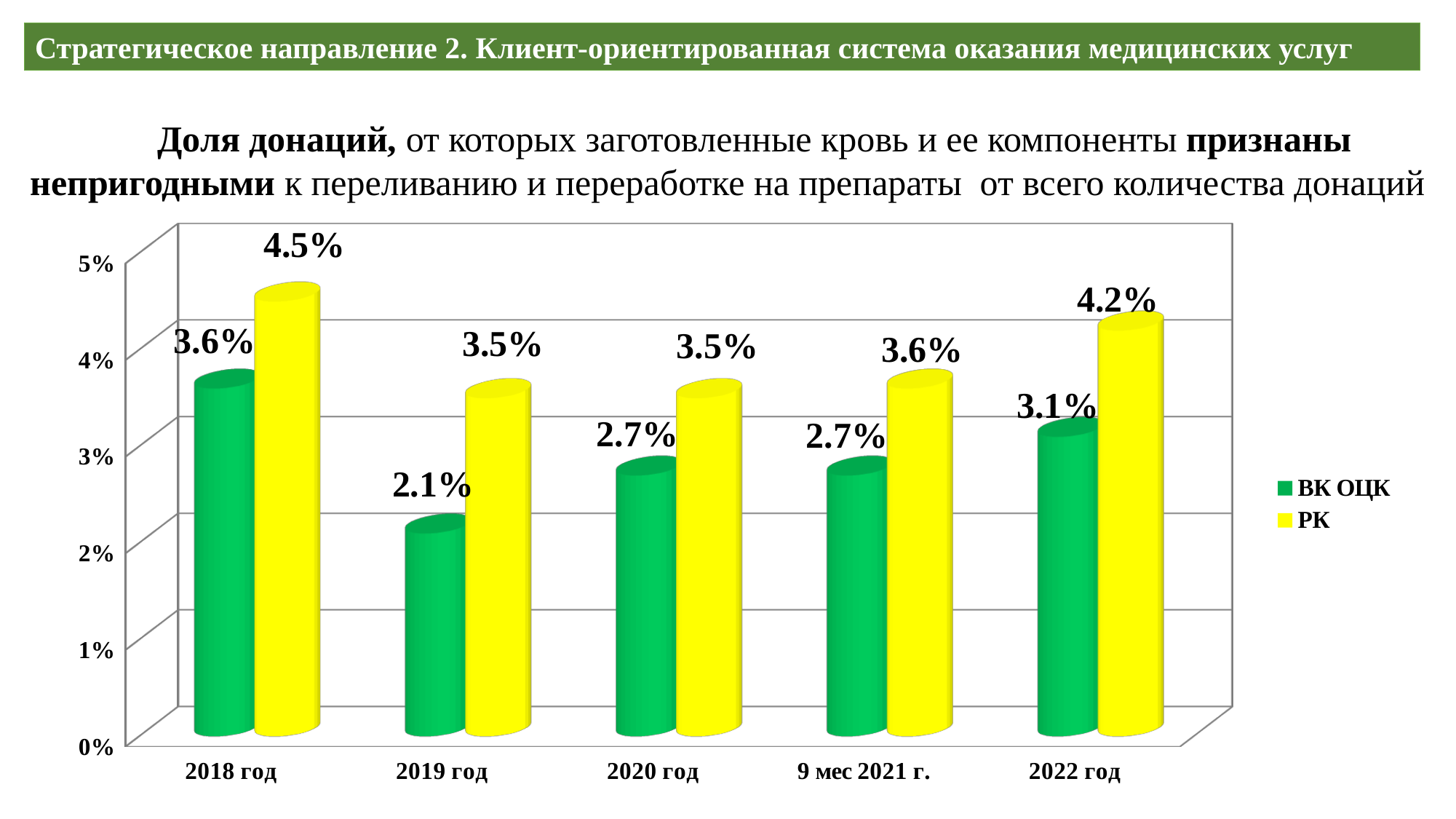
In which category is the РК value the highest? 2018 год What is the difference between the РК and ВК ОЦК values in 2019 год? 1.4% What is the value for РК in 9 мес 2021 г.? 3.6% In which category is the ВК ОЦК value the lowest? 2019 год Which colour represents the РК series in the legend? Yellow What is the value for ВК ОЦК in 2019 год? 2.1% What is the value for РК in 2018 год? 4.5% What kind of chart is shown on the slide? Bar chart What is the value for ВК ОЦК in 2022 год? 3.1% Which is larger in 2022 год, the ВК ОЦК value or the РК value? РК How many categories are shown on the x axis? 5 How many series does the legend list? 2